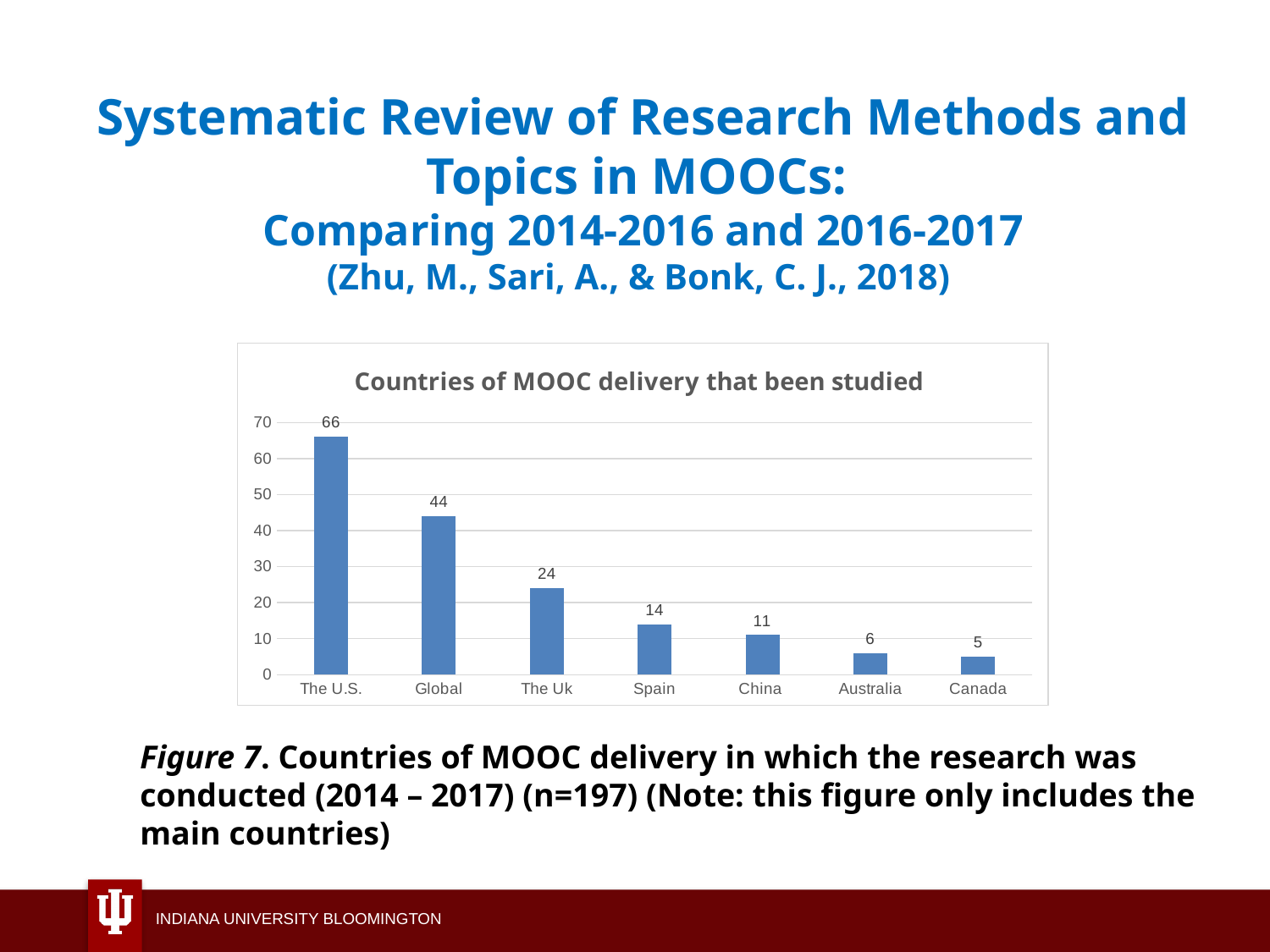
What is the value for The U.S.? 66 Which country has the highest value? The U.S. What is the value for Spain? 14 What is the difference between the values for The Uk and China? 13 What is the value for Canada? 5 What is the difference between the values for The U.S. and Global? 22 How many categories are shown on the x axis? 7 Is the value for Global greater or less than 40? greater What is the title of the chart? Countries of MOOC delivery that been studied Which is larger, the value for China or the value for Australia? China What kind of chart is shown? Bar chart Which category has the lowest value? Canada